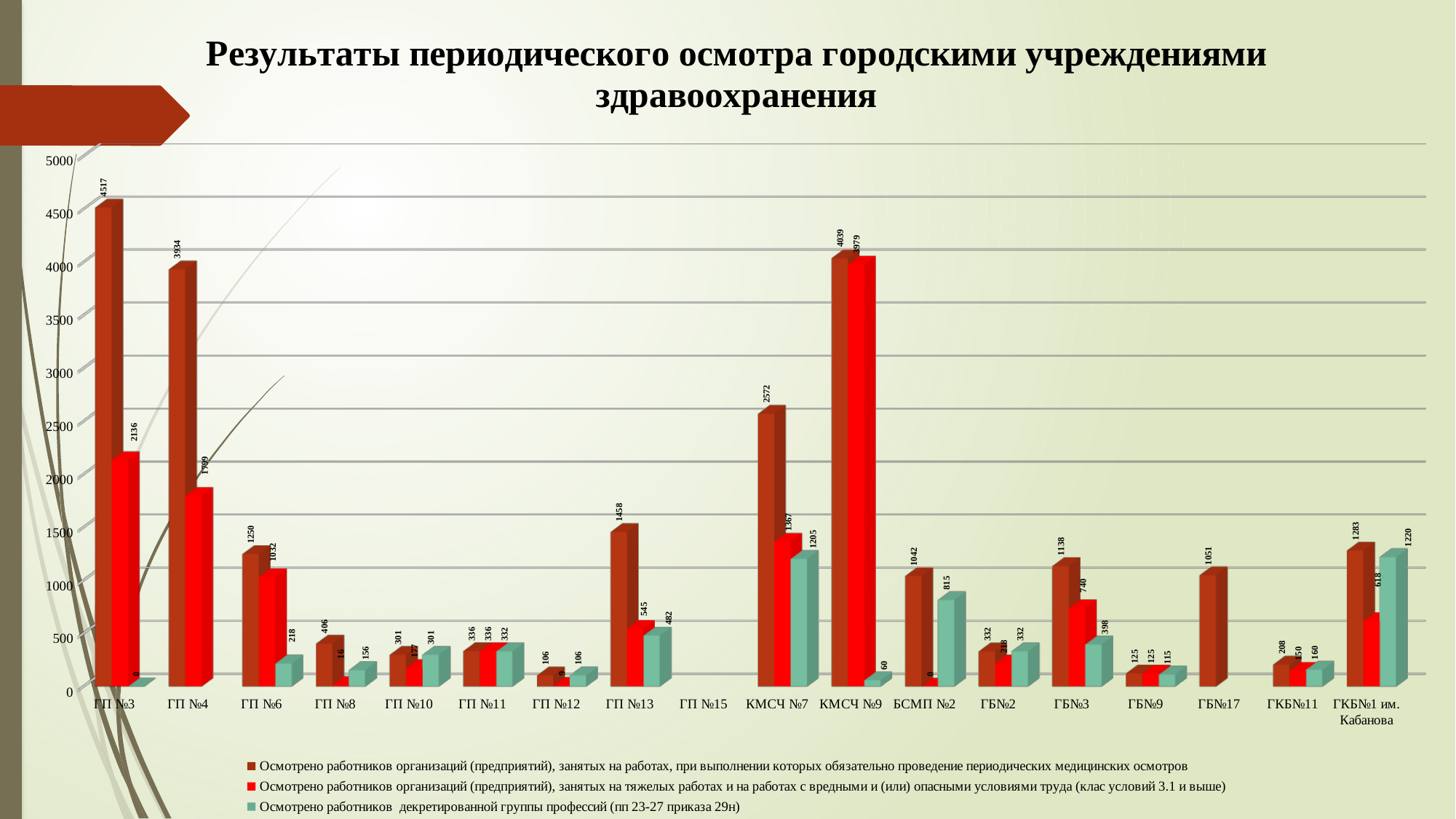
How many series does the legend list? 3 How many institutions (categories) are shown on the x axis? 18 What is the difference between the dark red and red series values for ГП №3? 2381 What is the value of the teal series (decreed group of professions) for ГКБ№1 им. Кабанова? 1220 Which institution has the highest value in the teal series (decreed group of professions)? ГКБ№1 им. Кабанова What is the difference between the dark red and red series values for КМСЧ №9? 60 Is the dark red series value for КМСЧ №7 greater or less than 2500? greater What is the value of the dark red series (workers subject to mandatory periodic medical examinations) for ГП №3? 4517 Which institution has the highest value in the dark red series (workers subject to mandatory periodic medical examinations)? ГП №3 What is the value of the red series (workers in heavy/hazardous conditions, class 3.1 and above) for КМСЧ №9? 3979 Which is larger in the dark red series: the value for ГП №13 or the value for ГБ№3? ГП №13 What type of chart is shown on the slide? bar chart